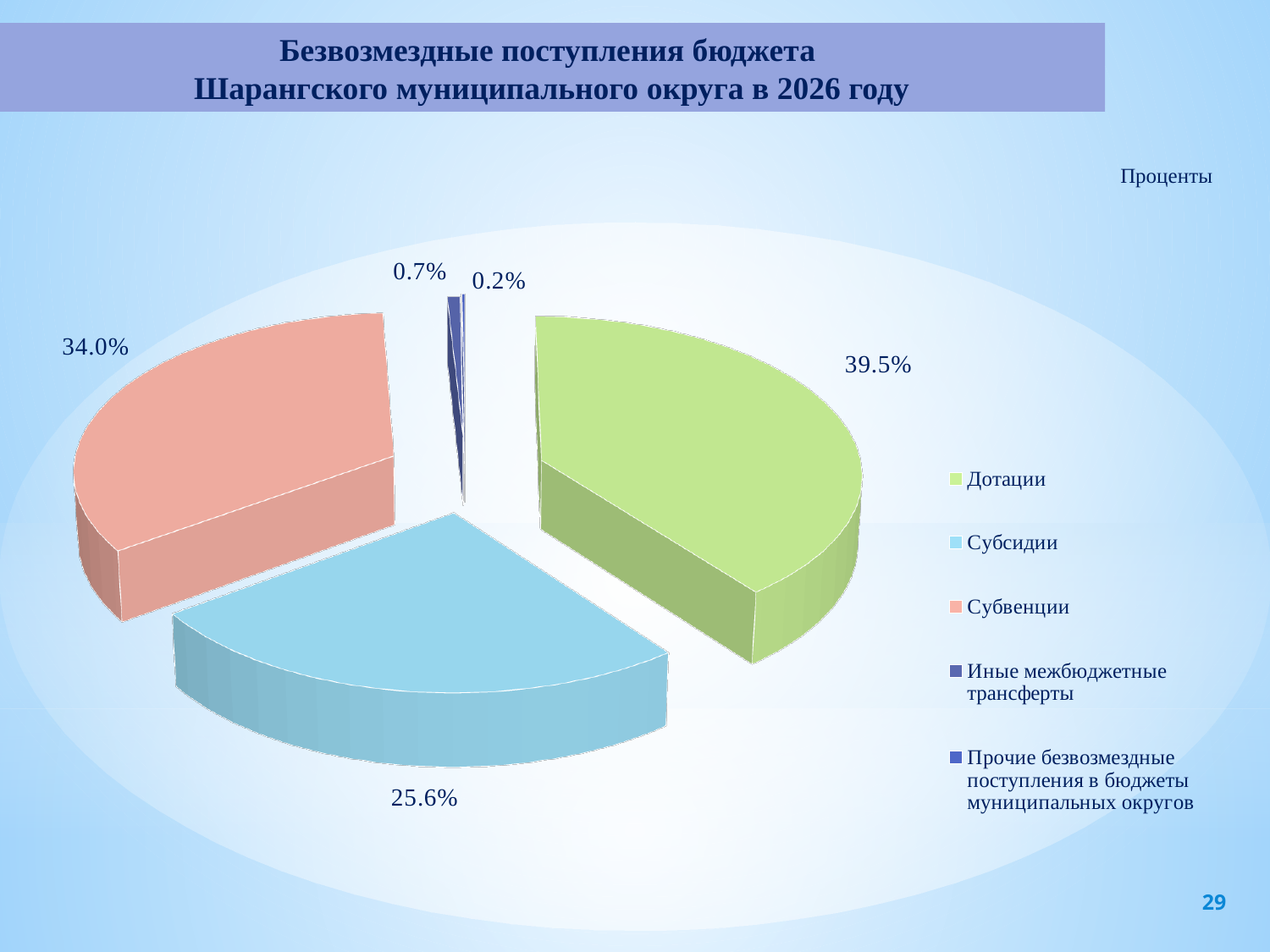
What share of the pie does Субсидии have? 25.6% What share of the pie does Дотации have? 39.5% Which category has the smallest share of the pie? Прочие безвозмездные поступления в бюджеты муниципальных округов What is the difference in percentage points between Дотации and Субвенции? 5.5 What is the title of the chart? Безвозмездные поступления бюджета Шарангского муниципального округа в 2026 году What share of the pie does Субвенции have? 34.0% Which is larger, the share for Субвенции or the share for Субсидии? Субвенции Which category has the largest share of the pie? Дотации What colour is the slice for Субсидии? light blue What share of the pie does Иные межбюджетные трансферты have? 0.7% What type of chart is shown on the slide? pie chart How many categories does the legend list? 5